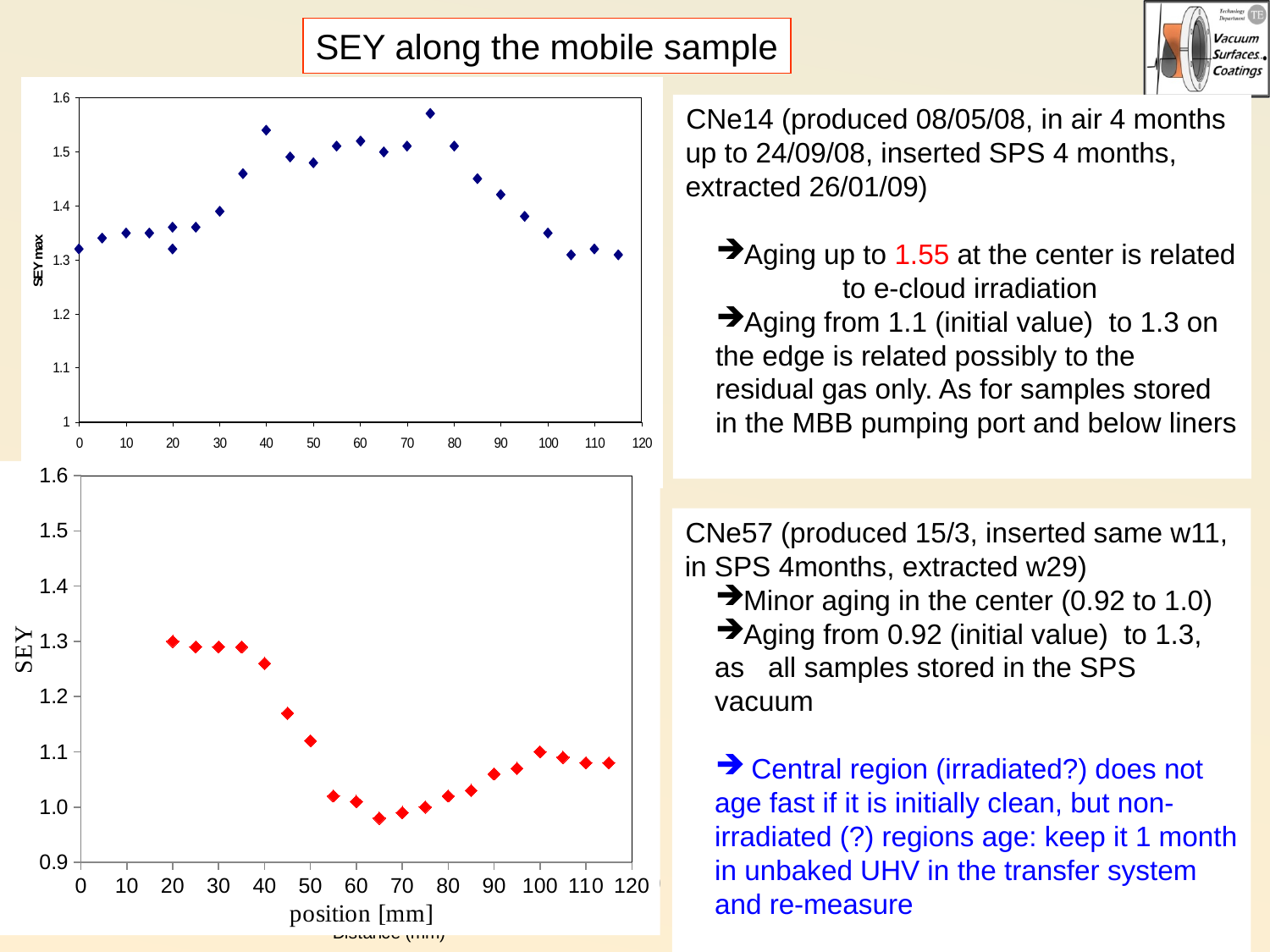
In the top chart (SEY max), do the values rise or fall from 75 mm to 115 mm? fall In the bottom chart (SEY vs position), is the value at 100 mm greater or less than 1.2? less In the bottom chart (SEY vs position), is the value at 65 mm greater or less than 1.0? less What kind of chart is the top chart (SEY max vs distance)? scatter chart In the top chart (SEY max), at which distance is the highest point plotted? 75 In the bottom chart (SEY vs position), do the values rise or fall from 20 mm to 65 mm? fall What is the x-axis label of the bottom chart? position [mm] What kind of chart is the bottom chart (SEY vs position)? scatter chart In the bottom chart (SEY vs position), is the value at 20 mm greater or less than 1.2? greater In the bottom chart, which is larger: the value at 20 mm or the value at 65 mm? 20 mm